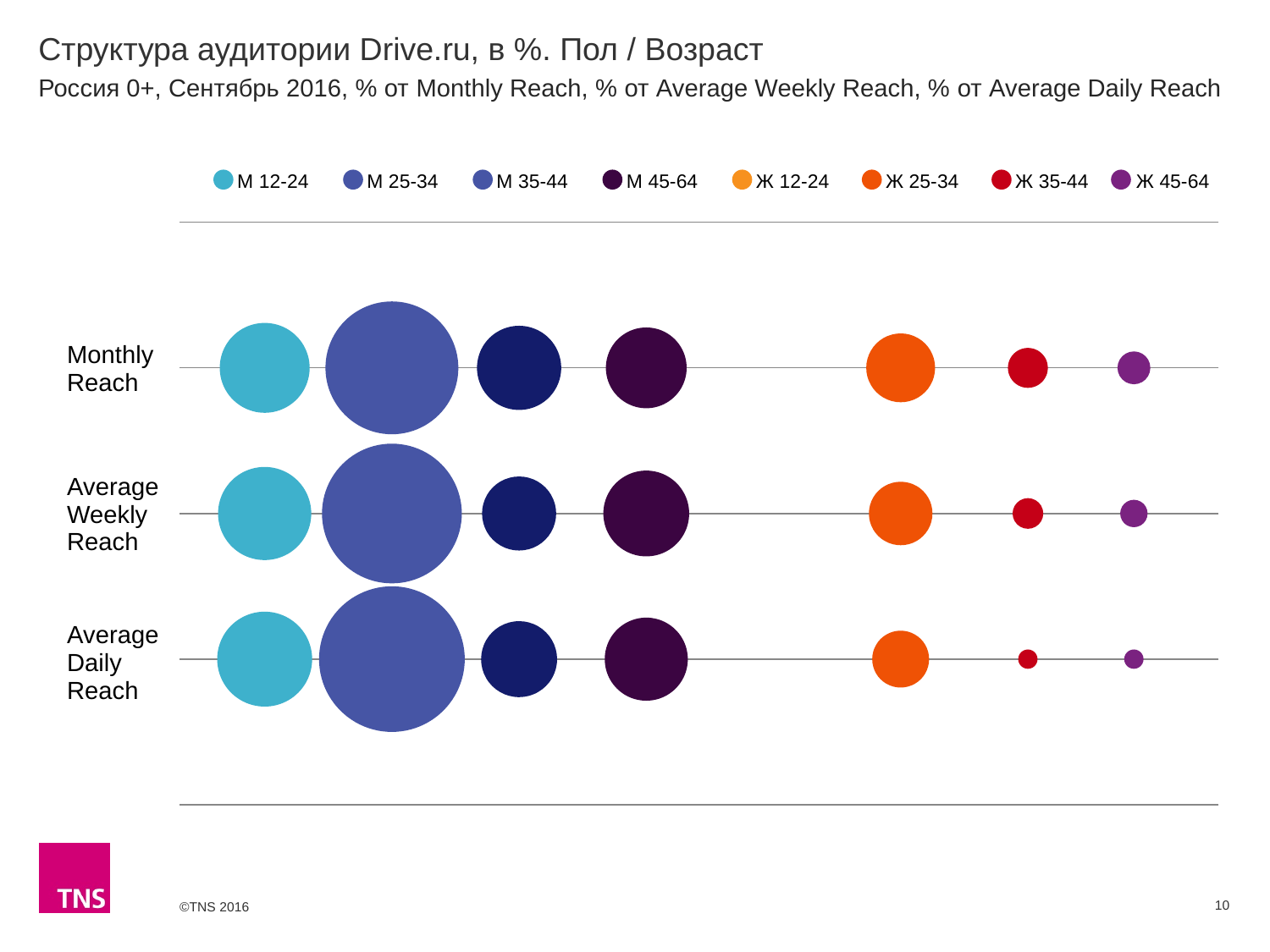
How many reach categories (rows) are plotted on the chart? 3 Which audience group has the largest bubble in the Average Weekly Reach row? М 25-34 How many series does the legend list? 8 Which row is listed first (at the top) of the chart? Monthly Reach In the Average Daily Reach row, which bubble is larger: М 12-24 or Ж 45-64? М 12-24 In the Average Weekly Reach row, which bubble is larger: Ж 25-34 or Ж 35-44? Ж 25-34 What is the title of the chart on the slide? Структура аудитории Drive.ru, в %. Пол / Возраст Which audience group has the largest bubble in the Monthly Reach row? М 25-34 Which audience group has the largest bubble in the Average Daily Reach row? М 25-34 What kind of chart is shown on the slide? Bubble chart In the Monthly Reach row, which bubble is larger: М 25-34 or Ж 35-44? М 25-34 Which legend entry has no visible bubble in any of the three rows? Ж 12-24